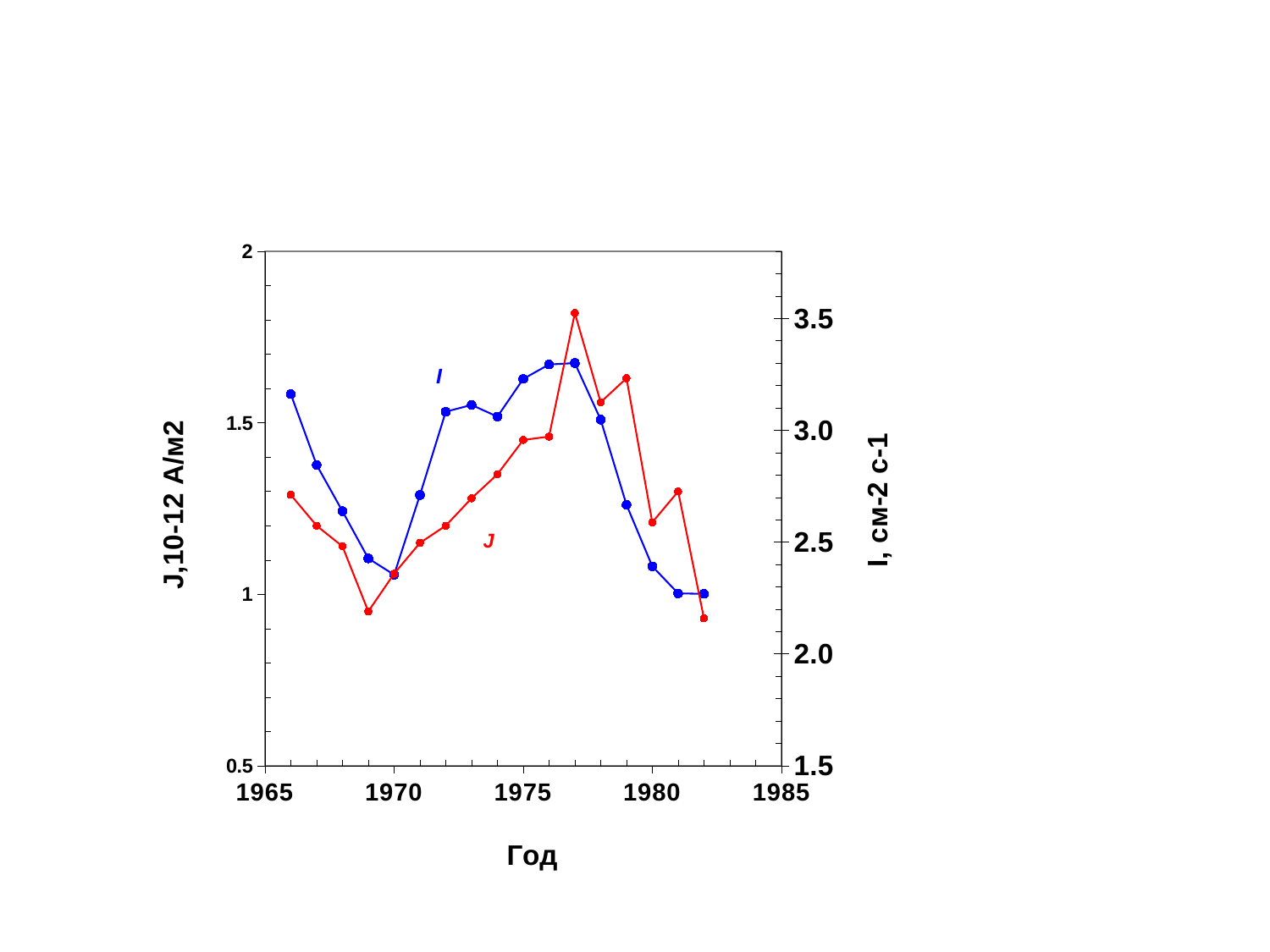
Which is larger, the value of J in 1977 or the value of J in 1970? 1977 How many series are plotted on the chart? 2 In which year does the J series reach its lowest value? 1982 What is the label of the x axis? Год Does the I series rise or fall between 1977 and 1982? fall Is the value of J in 1977 greater or less than 1.5? greater How many data points does the J series have? 17 Is the value of I in 1970 greater or less than 2.5? less Is the value of J in 1966 greater or less than 1.5? less Does the J series rise or fall between 1970 and 1977? rise In which year does the J series reach its highest value? 1977 What kind of chart is shown on the slide? line chart